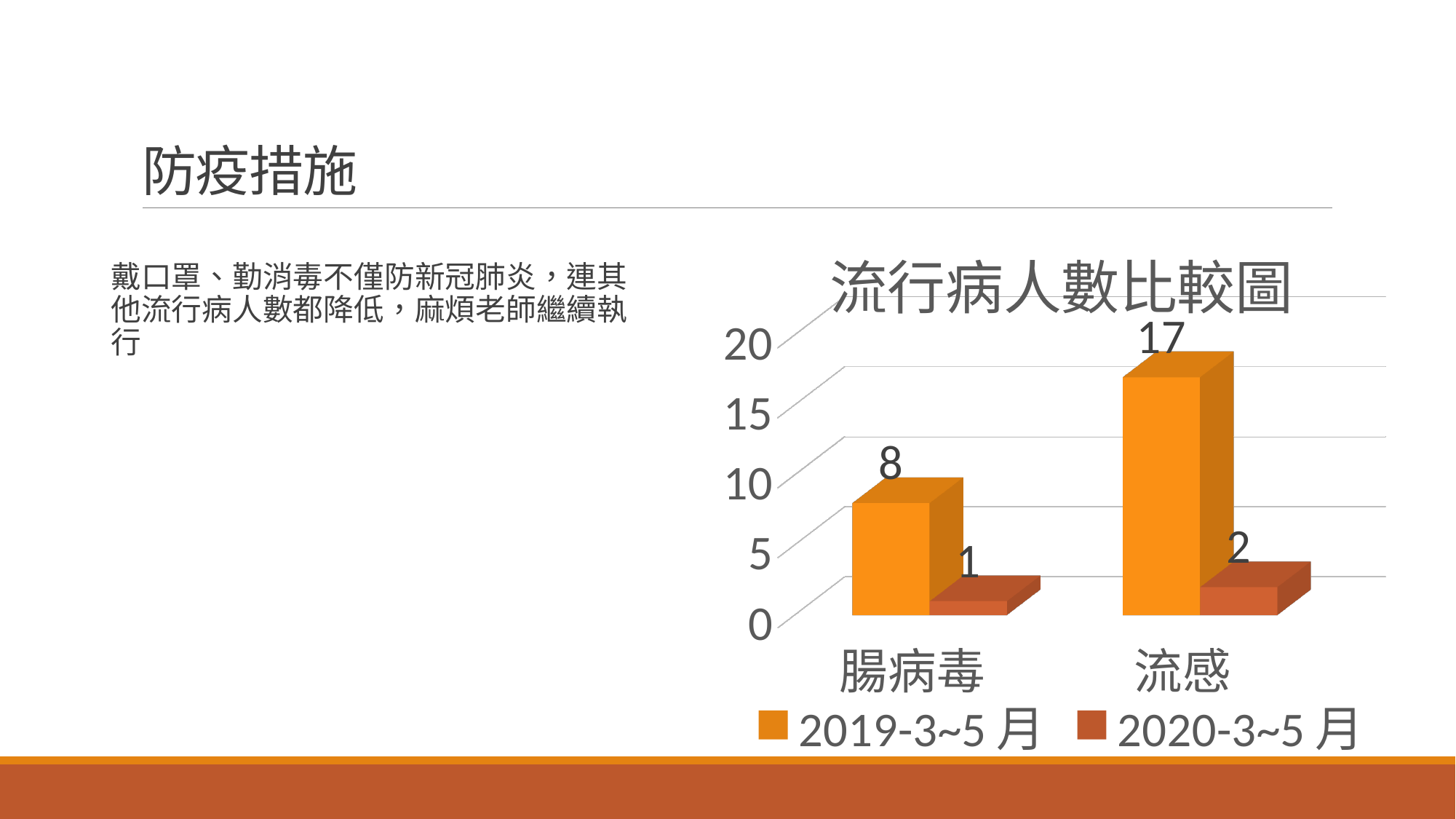
What is the title of the chart? 流行病人數比較圖 What is the difference between the 2019-3~5 月 and 2020-3~5 月 values for 腸病毒? 7 How many categories are shown on the x axis? 2 What is the value for 流感 in the 2020-3~5 月 series? 2 Which is larger: the 2019-3~5 月 value for 腸病毒 or the 2020-3~5 月 value for 流感? 2019-3~5 月 value for 腸病毒 What is the value for 腸病毒 in the 2019-3~5 月 series? 8 What is the difference between the 2019-3~5 月 and 2020-3~5 月 values for 流感? 15 What kind of chart is shown on the slide? Bar chart How many series does the legend list? 2 Which category has the highest value in the 2019-3~5 月 series? 流感 What is the value for 腸病毒 in the 2020-3~5 月 series? 1 Which category has the lowest value in the 2020-3~5 月 series? 腸病毒